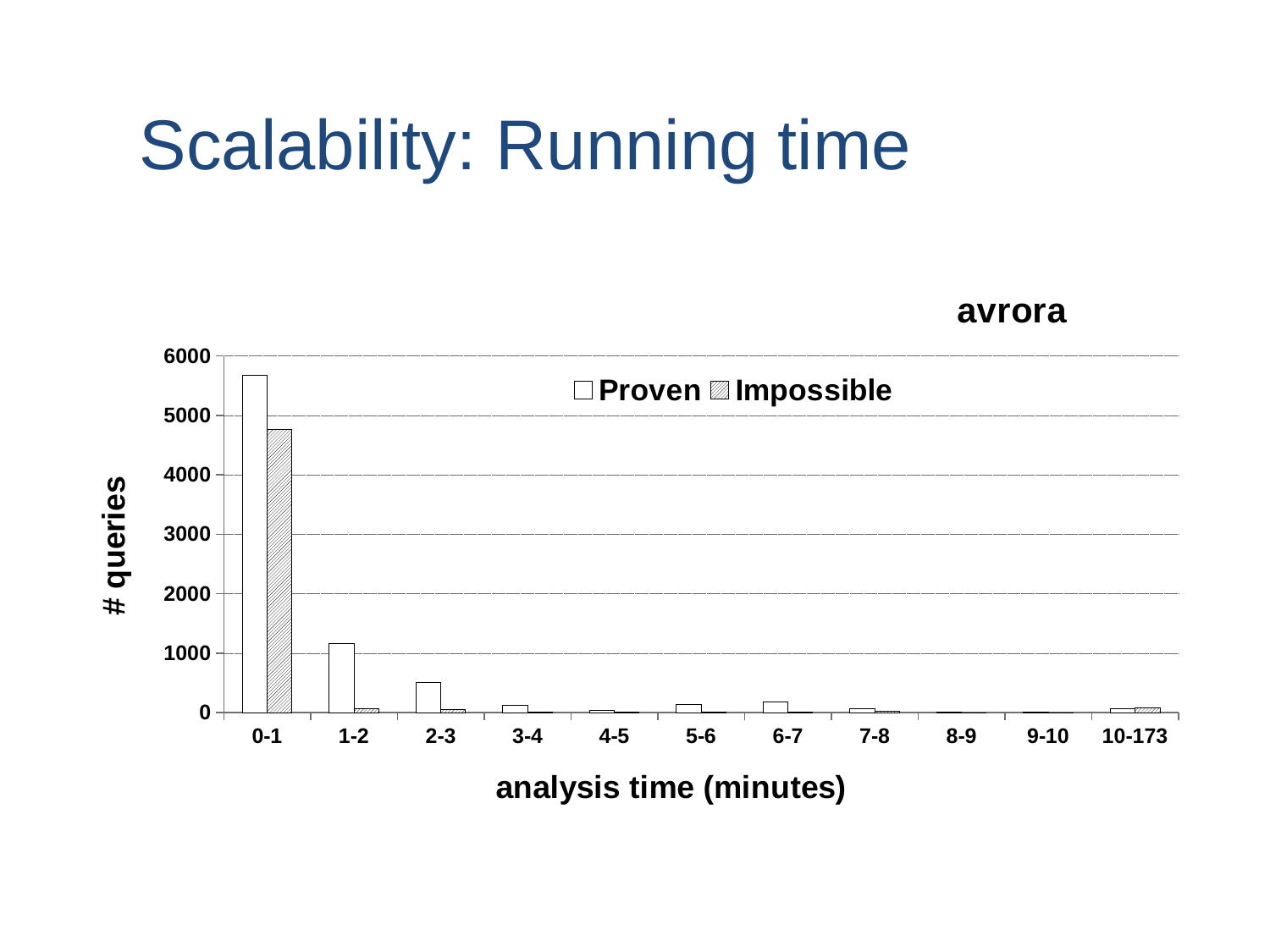
Which analysis-time category has the highest number of Proven queries? 0-1 In the 0-1 minute category, which series has more queries, Proven or Impossible? Proven What kind of chart is shown on the slide? bar chart Do the Proven query counts rise or fall from the 0-1 category to the 2-3 category? fall What is the title of the chart? avrora Is the number of Proven queries in the 1-2 minute category greater or less than 1000? greater Is the number of Impossible queries in the 0-1 minute category greater or less than 5000? less Is the number of Proven queries in the 0-1 minute category greater or less than 5000? greater How many series does the legend list? 2 Which analysis-time category has the highest number of Impossible queries? 0-1 How many analysis-time categories are shown on the x axis? 11